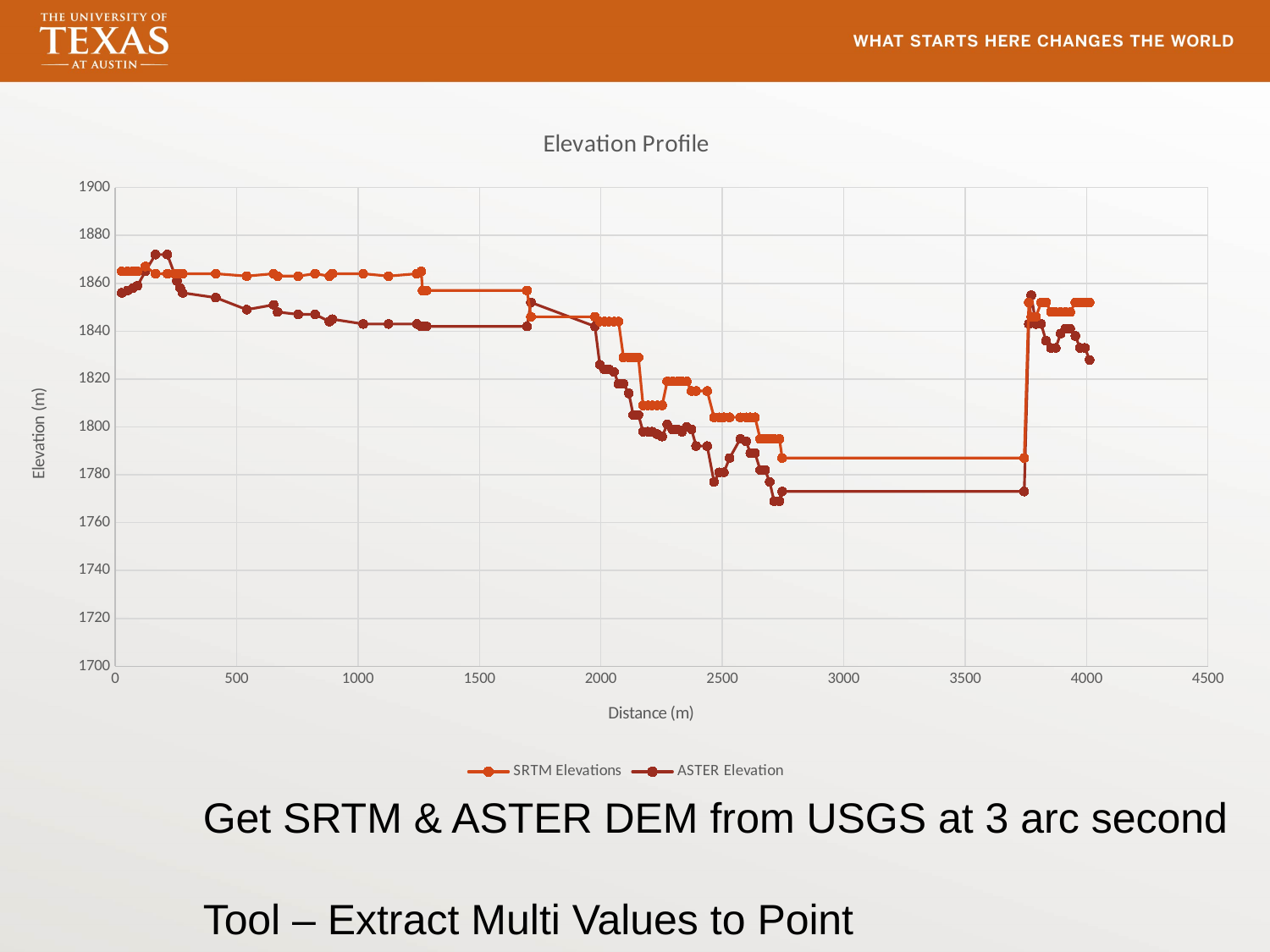
Is the SRTM Elevations value at a distance of 3000 m greater or less than 1800? less Is the ASTER Elevation value at a distance of 1000 m greater or less than 1860? less What are the names of the two series in the legend? SRTM Elevations and ASTER Elevation What type of chart is shown on the slide? Line chart Is the ASTER Elevation value at a distance of 3000 m greater or less than 1780? less At a distance of 3000 m, which series has the higher elevation, SRTM Elevations or ASTER Elevation? SRTM Elevations What is the title of the chart? Elevation Profile How many series does the chart's legend list? 2 Which series reaches the lowest elevation anywhere on the chart? ASTER Elevation At a distance of 1000 m, which series has the higher elevation, SRTM Elevations or ASTER Elevation? SRTM Elevations Between distances of 2000 m and 2750 m, do the SRTM Elevations values rise or fall? fall